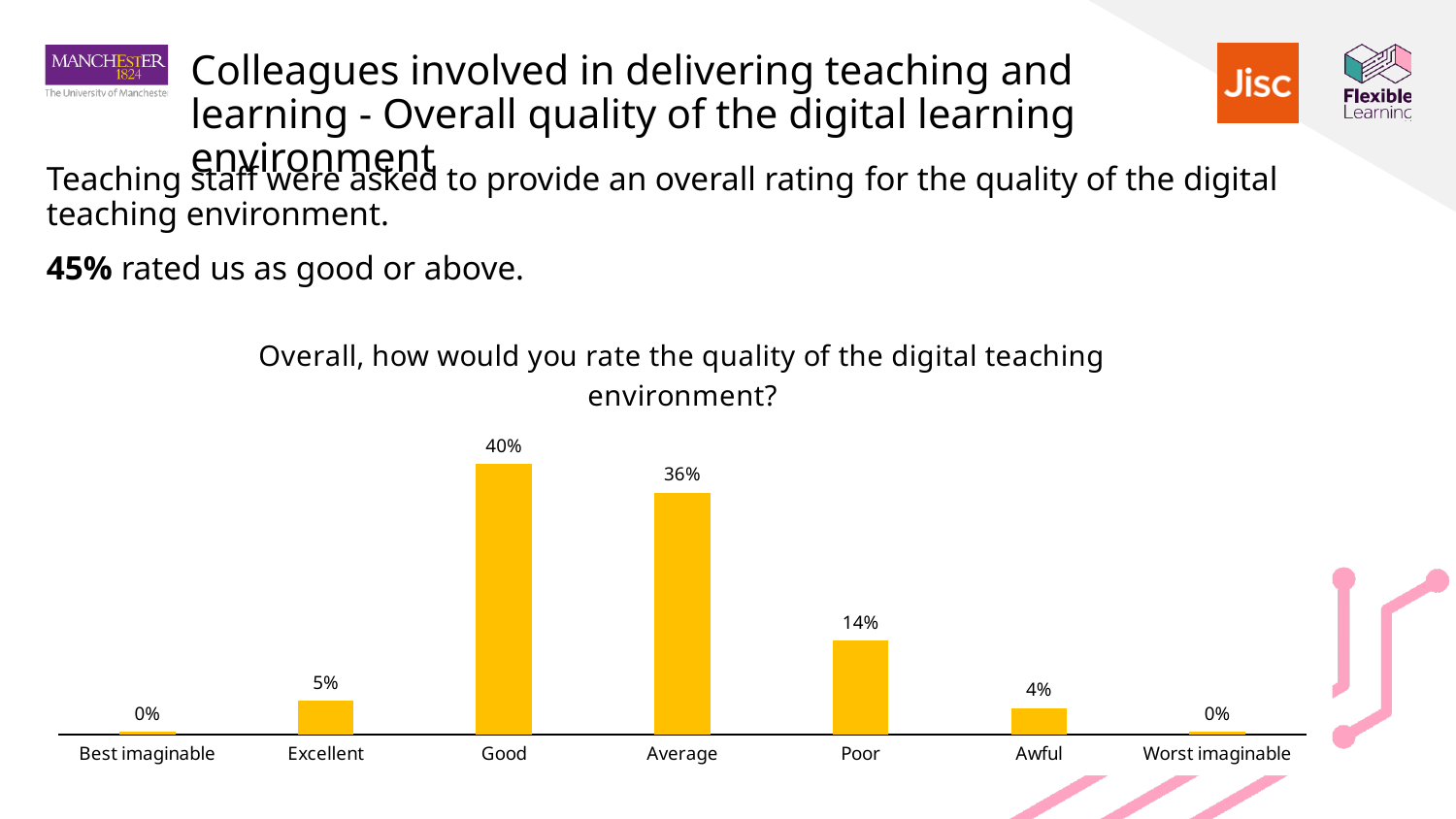
What percentage of teaching staff rated the digital teaching environment as Awful? 4% What percentage of teaching staff rated the digital teaching environment as Good? 40% Which has a higher percentage, Excellent or Poor? Poor What percentage of teaching staff rated the digital teaching environment as Average? 36% What percentage of teaching staff rated the digital teaching environment as Poor? 14% What percentage of teaching staff rated the digital teaching environment as Excellent? 5% What is the difference in percentage points between the Good and Average ratings? 4% What type of chart is used to show the ratings? Bar chart What is the difference in percentage points between the Poor and Awful ratings? 10% How many rating categories are shown on the x axis? 7 Which rating category has the highest percentage? Good What is the title of the chart? Overall, how would you rate the quality of the digital teaching environment?